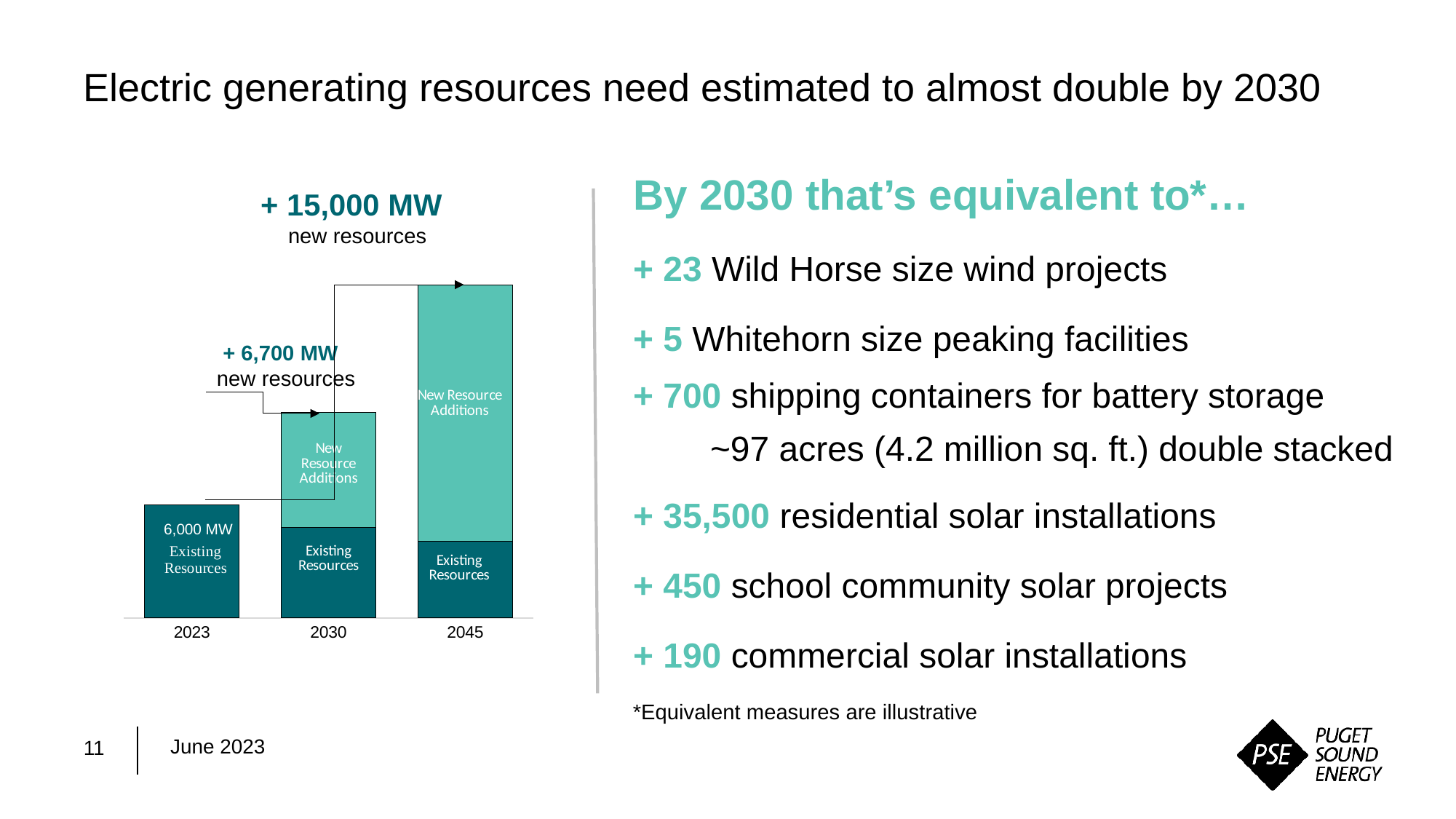
How much larger is the new resources figure for 2045 than for 2030? 8,300 MW Which year has the tallest bar in the chart? 2045 What is the title of the slide containing the chart? Electric generating resources need estimated to almost double by 2030 How many MW of new resources are labelled as added by 2045? + 15,000 MW Which year has the shortest bar in the chart? 2023 How many years are shown on the x axis of the chart? 3 Which year has the larger New Resource Additions segment, 2030 or 2045? 2045 What are the two segment labels used in the stacked bars? Existing Resources and New Resource Additions What kind of chart is shown on the slide? Stacked bar chart What is the value of Existing Resources in 2023? 6,000 MW How many MW of new resources are labelled as added by 2030? + 6,700 MW Do the total bar heights rise or fall from 2023 to 2045? Rise